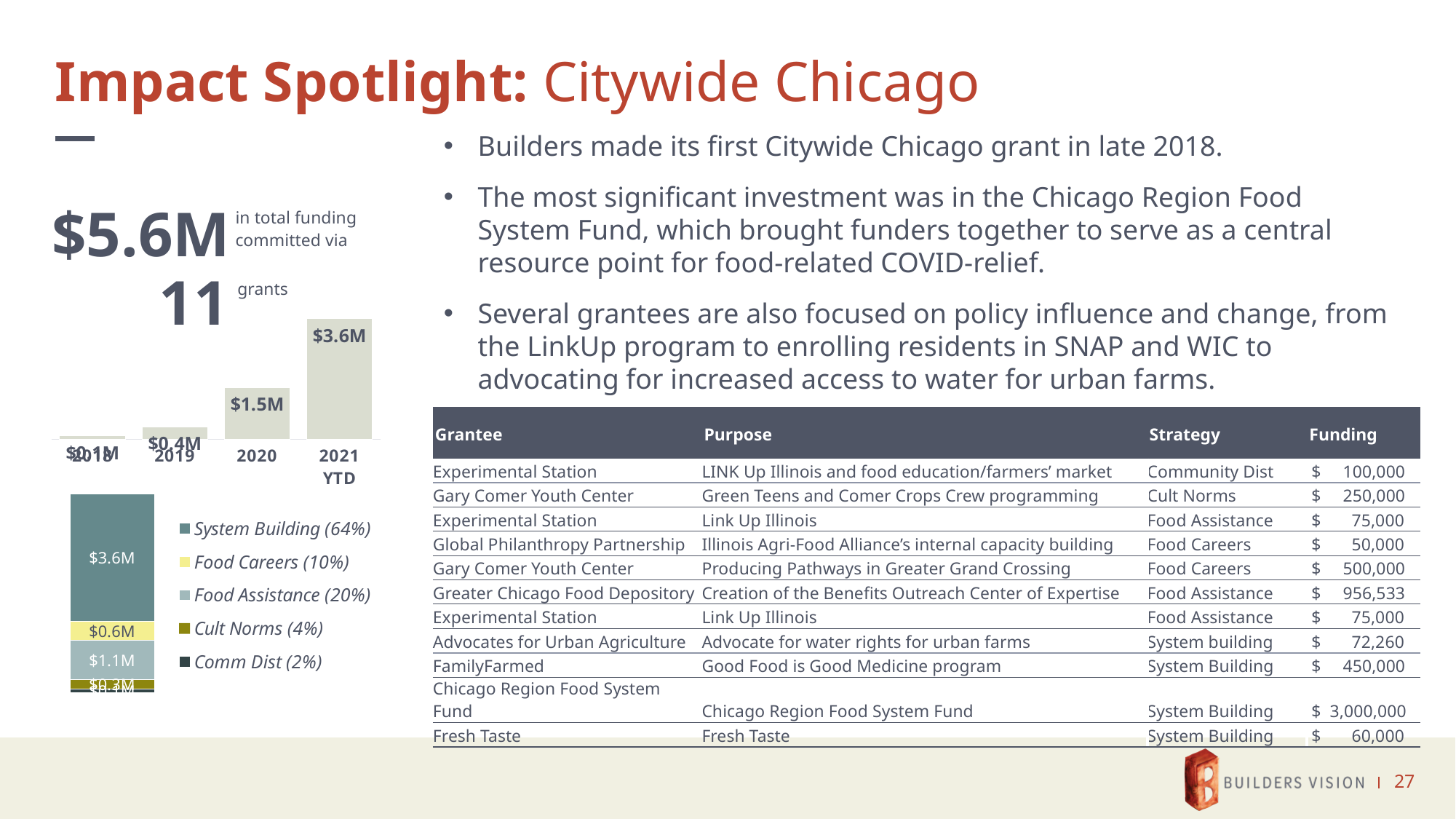
In the bar chart of funding by year, which year has the highest value? 2021 YTD In the bar chart of funding by year, what is the value for 2020? $1.5M In the bar chart of funding by year, do the values rise or fall from 2018 to 2021 YTD? rise In the stacked bar chart by strategy, what is the value for System Building? $3.6M What kind of chart is the chart of funding by year? bar chart In the bar chart of funding by year, what is the difference between the 2021 YTD and 2020 values? $2.1M In the bar chart of funding by year, what is the value for 2021 YTD? $3.6M In the stacked bar chart by strategy, what is the value for Food Assistance? $1.1M In the bar chart of funding by year, what is the value for 2019? $0.4M In the bar chart of funding by year, how many years are shown on the x axis? 4 How many series does the legend of the stacked bar chart by strategy list? 5 In the bar chart of funding by year, which year has the lowest value? 2018